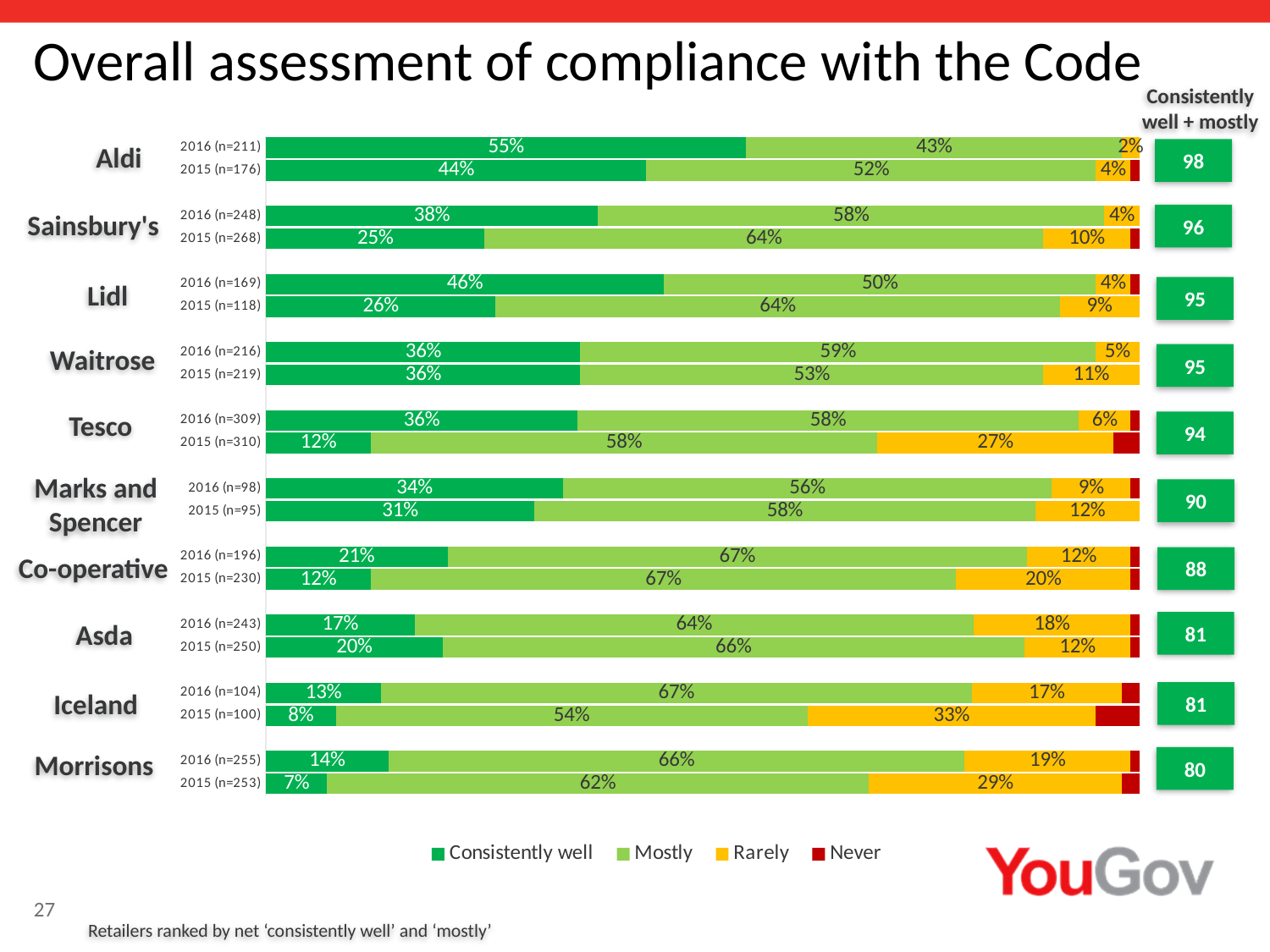
What is the title of the chart? Overall assessment of compliance with the Code Which is larger: the 'Rarely' value for Iceland in 2015 or for Iceland in 2016? Iceland 2015 Which retailer and year has the lowest 'Consistently well' percentage? Morrisons 2015 What percentage of Aldi respondents in 2016 said the retailer complied 'Consistently well'? 55% How many retailers are shown in the chart? 10 By how many percentage points did Sainsbury's 'Consistently well' share change from 2015 to 2016? 13 percentage points Which retailer and year has the highest 'Consistently well' percentage? Aldi 2016 What is the 'Consistently well + mostly' net score for Morrisons? 80 What kind of chart is shown on the slide? Stacked bar chart How many series does the legend list? 4 What is the 'Rarely' value for Tesco in 2015? 27%